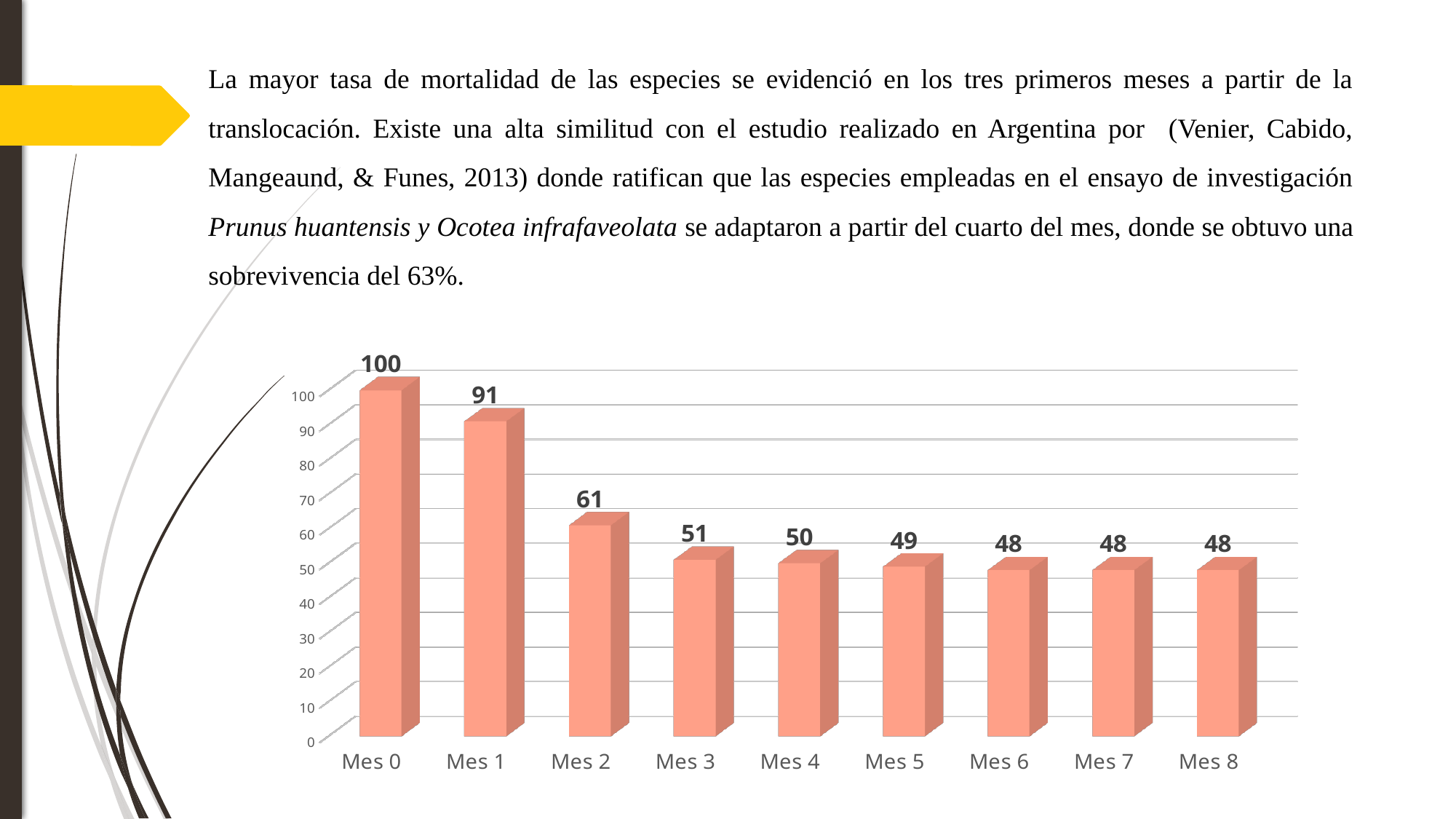
What is the value for Mes 2? 61 What kind of chart is shown on the slide? bar chart Is the value for Mes 5 greater or less than 60? less Do the values rise or fall from Mes 0 to Mes 8? fall What is the difference between the values for Mes 0 and Mes 1? 9 What value is shared by Mes 6, Mes 7 and Mes 8? 48 What is the value for Mes 4? 50 Which month has the highest value? Mes 0 Which is larger, the value for Mes 2 or the value for Mes 3? Mes 2 How many months are shown on the x axis? 9 What is the value for Mes 0? 100 What is the difference between the values for Mes 1 and Mes 2? 30